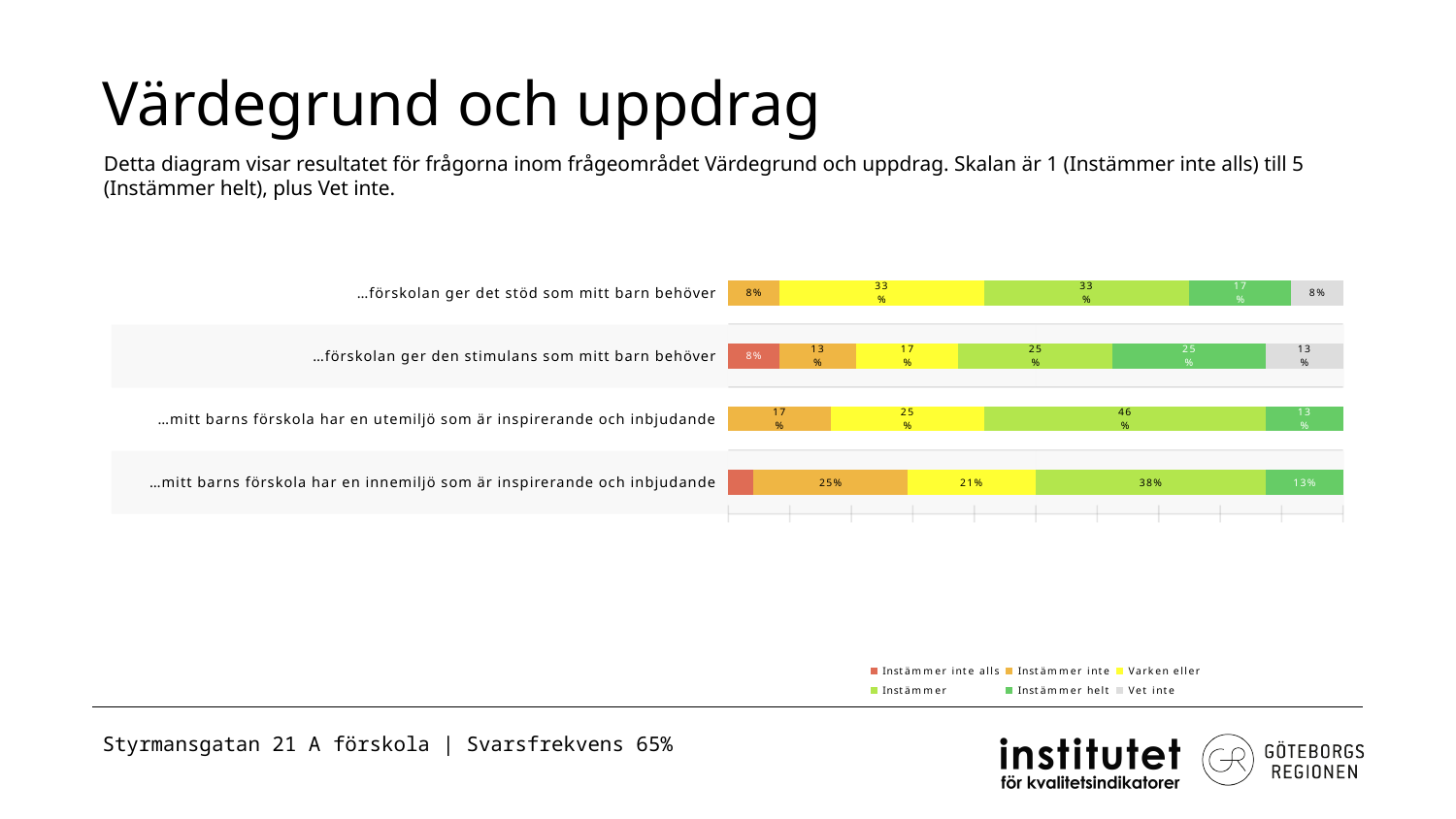
Which has the larger 'Instämmer helt' value: '…förskolan ger det stöd som mitt barn behöver' or '…förskolan ger den stimulans som mitt barn behöver'? …förskolan ger den stimulans som mitt barn behöver What kind of chart is shown on the slide? Stacked bar chart What colour represents 'Vet inte' in the legend? Grey How many series does the legend list? 6 What is the 'Instämmer inte' value for '…mitt barns förskola har en innemiljö som är inspirerande och inbjudande'? 25% Which statement has the highest 'Instämmer' value? …mitt barns förskola har en utemiljö som är inspirerande och inbjudande What is the 'Instämmer' value for '…mitt barns förskola har en innemiljö som är inspirerande och inbjudande'? 38% What is the difference between the 'Instämmer' values for the utemiljö statement and the innemiljö statement? 8 percentage points How many statements (categories) are plotted in the chart? 4 What is the 'Instämmer helt' value for '…mitt barns förskola har en utemiljö som är inspirerande och inbjudande'? 13% What is the 'Varken eller' value for '…förskolan ger det stöd som mitt barn behöver'? 33% What is the 'Vet inte' value for '…förskolan ger den stimulans som mitt barn behöver'? 13%